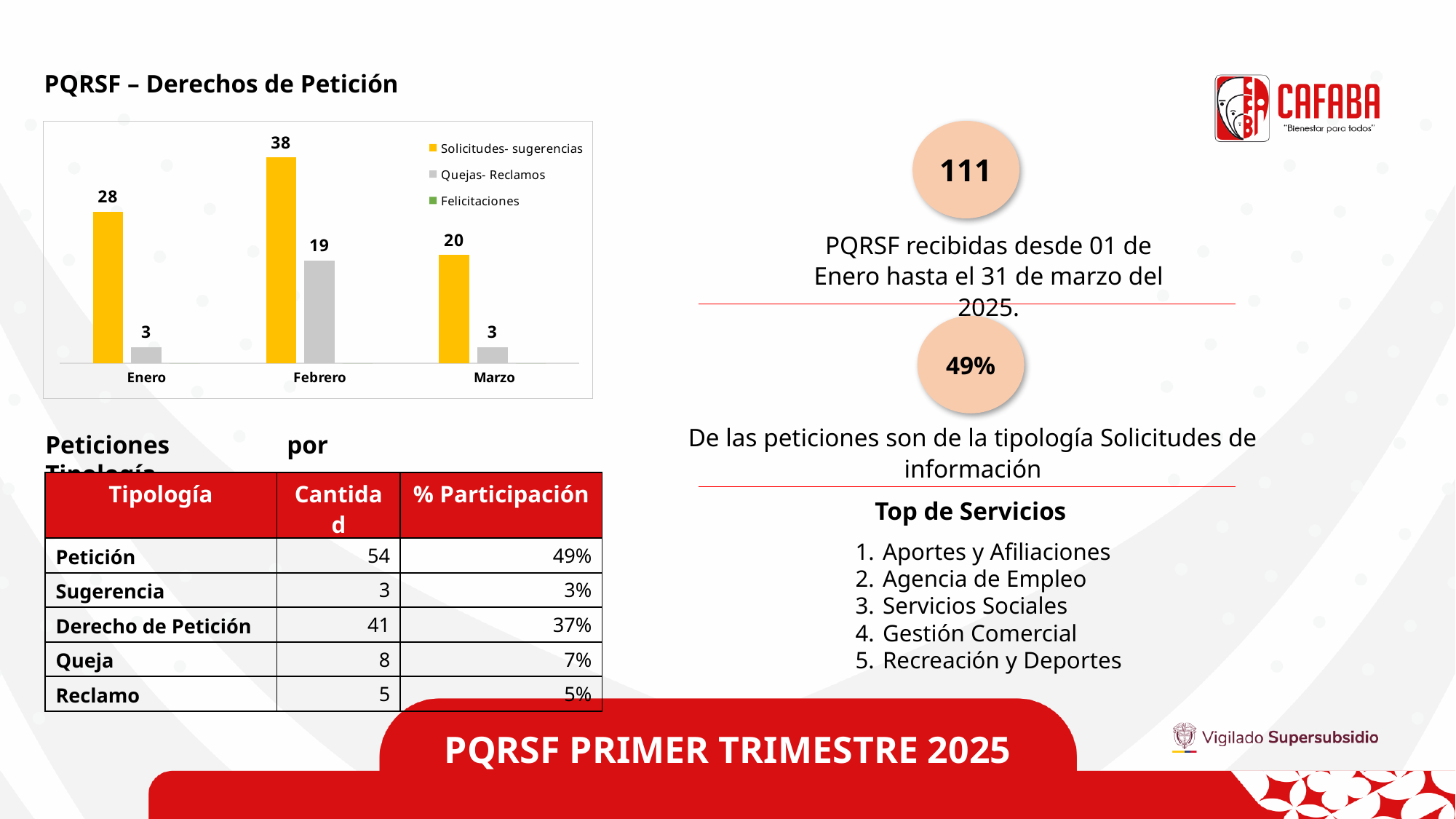
What is the difference between Solicitudes- sugerencias in Febrero and in Enero? 10 How many series does the chart legend list? 3 What is the value for Solicitudes- sugerencias in Febrero? 38 What is the value for Quejas- Reclamos in Enero? 3 Which month has the highest value for Solicitudes- sugerencias? Febrero Which is larger: Solicitudes- sugerencias in Enero or Solicitudes- sugerencias in Marzo? Solicitudes- sugerencias in Enero What type of chart is shown on the slide? Bar chart What is the value for Solicitudes- sugerencias in Marzo? 20 Which month has the lowest value for Solicitudes- sugerencias? Marzo What is the value for Quejas- Reclamos in Febrero? 19 How many months are shown on the x axis of the chart? 3 What is the difference between Solicitudes- sugerencias and Quejas- Reclamos in Febrero? 19